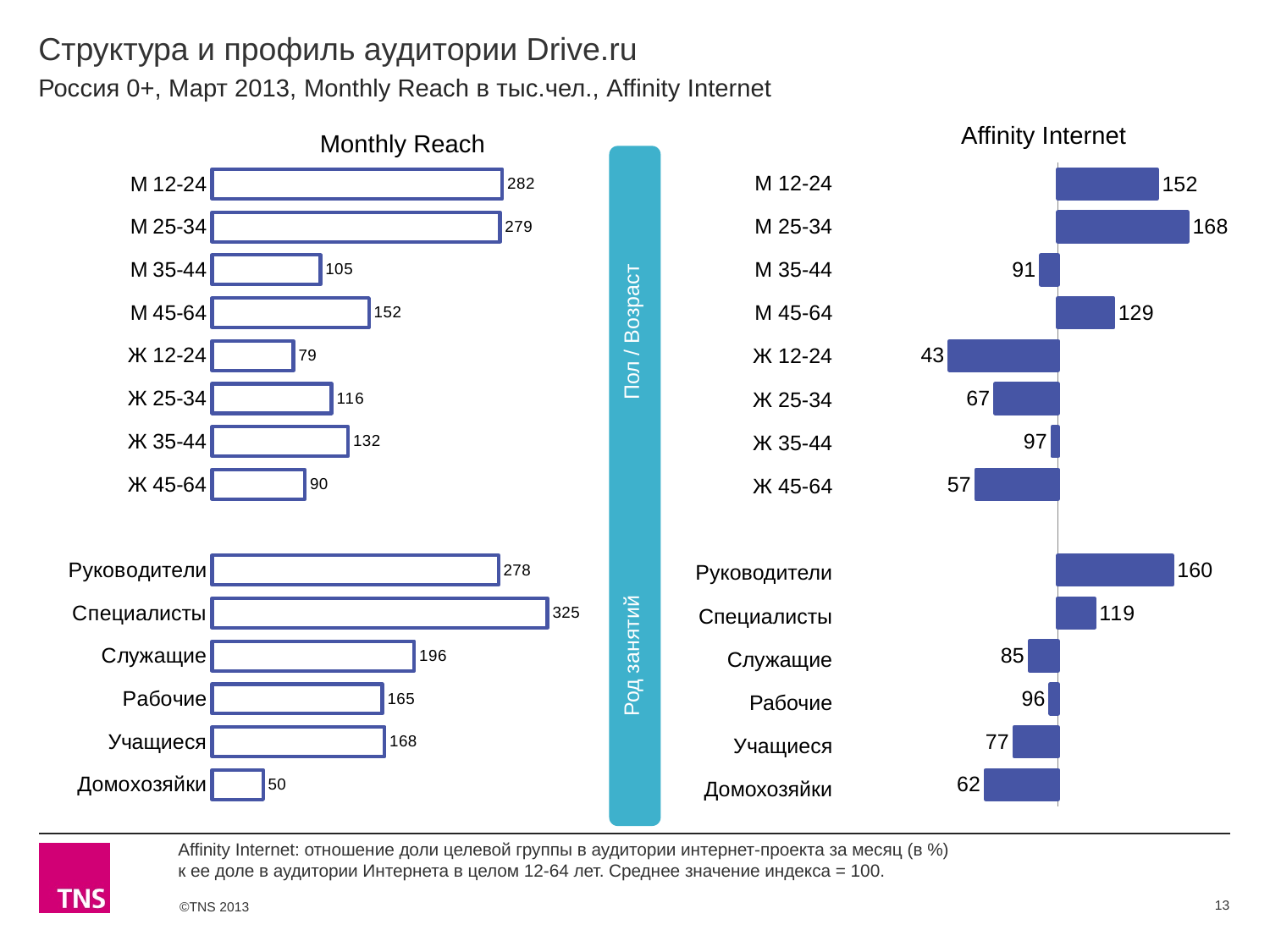
In the Affinity Internet chart, what is the value for Ж 12-24? 43 What kind of chart is the Affinity Internet chart? Bar chart In the Affinity Internet chart, which category has the highest value? М 25-34 In the Monthly Reach chart, what is the value for Специалисты? 325 How many categories are plotted in the Monthly Reach chart? 14 In the Monthly Reach chart, what is the difference between the values for М 12-24 and М 25-34? 3 In the Monthly Reach chart, which category has the highest value? Специалисты In the Affinity Internet chart, what is the value for Руководители? 160 In the Affinity Internet chart, which is larger, the value for Служащие or the value for Рабочие? Рабочие In the Monthly Reach chart, what is the value for М 12-24? 282 In the Affinity Internet chart, which category has the lowest value? Ж 12-24 In the Monthly Reach chart, which category has the lowest value? Домохозяйки